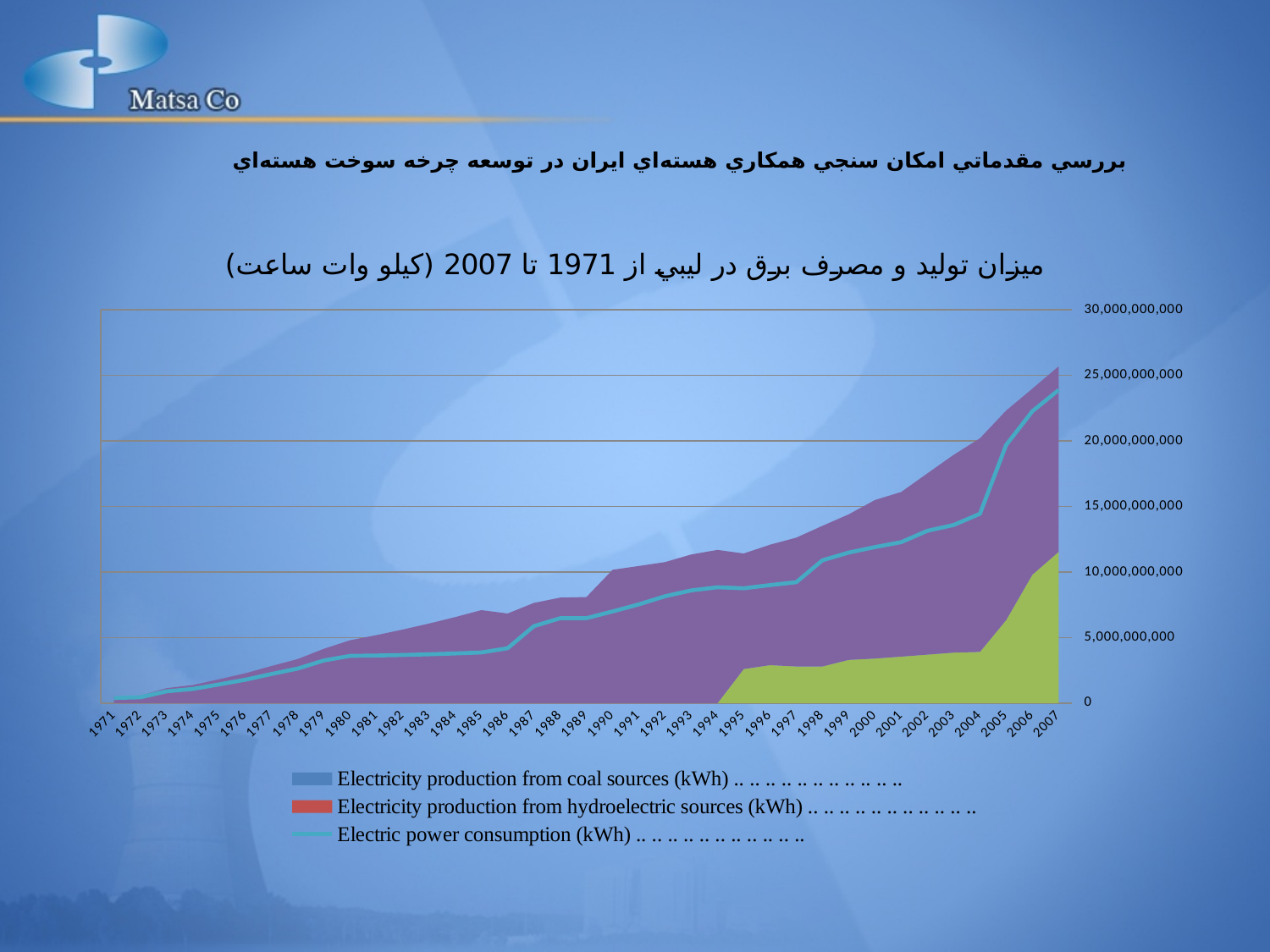
How many series does the chart legend list? 3 What kind of chart is shown on the slide? combination area and line chart What is the last year shown on the x axis of the chart? 2007 Is the value of Electric power consumption (kWh) in 2007 greater or less than 20,000,000,000? greater Is the value of Electric power consumption (kWh) in 1971 greater or less than 5,000,000,000? less In which year is the Electric power consumption (kWh) line at its highest? 2007 Is the value of Electric power consumption (kWh) in 1980 greater or less than 5,000,000,000? less Does the Electric power consumption (kWh) line rise or fall from 1971 to 2007? rise How many years are shown along the x axis of the chart? 37 What is the first year shown on the x axis of the chart? 1971